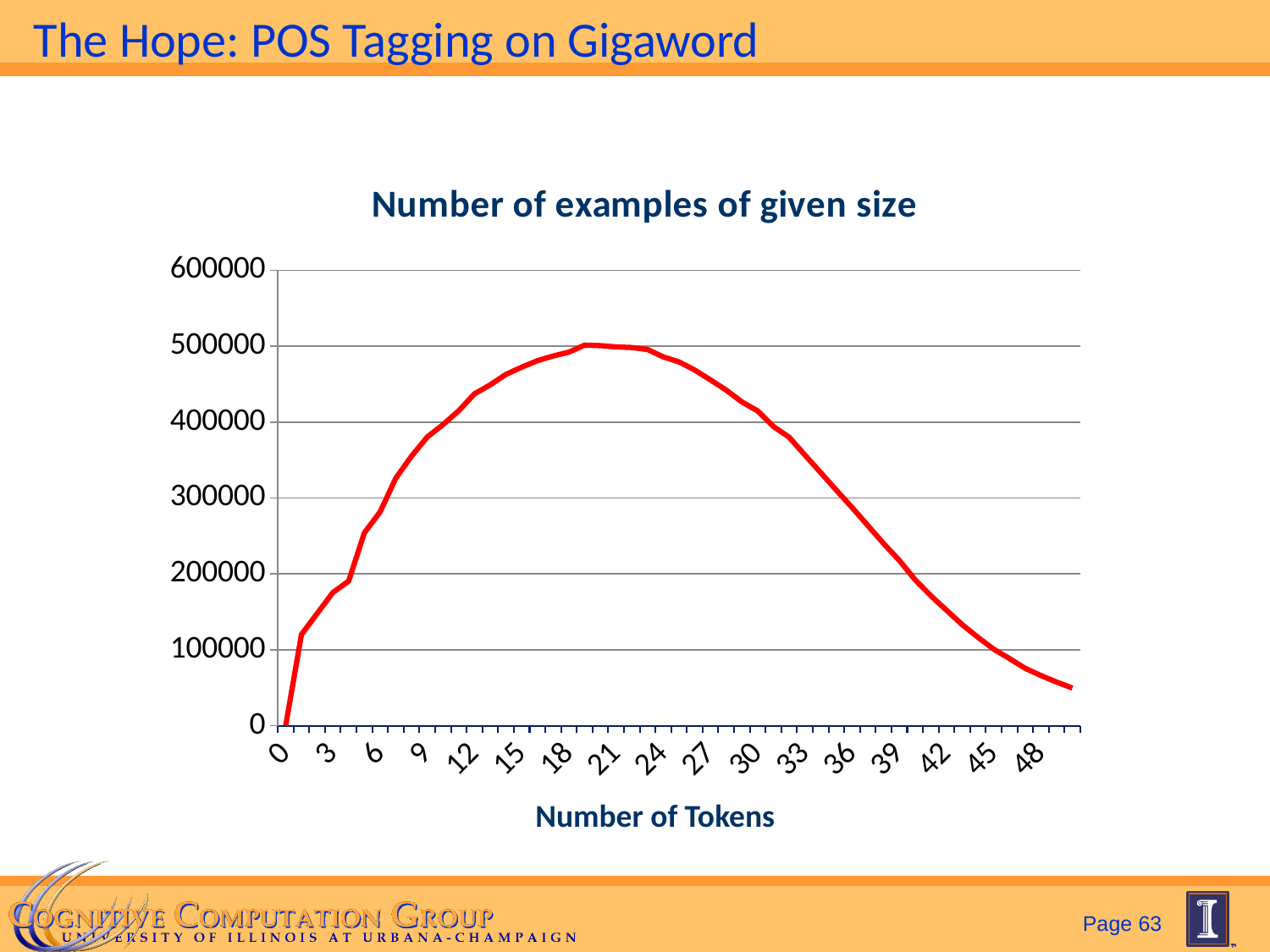
Is the value at 9 tokens greater or less than 300000? greater Which has more examples: 12 tokens or 42 tokens? 12 tokens What kind of chart is shown on the slide? line chart Does the number of examples rise or fall as the number of tokens goes from 0 to 18? rise Is the value at 18 tokens greater or less than 400000? greater Which has more examples: 6 tokens or 30 tokens? 30 tokens Is the value at 48 tokens greater or less than 100000? less Does the number of examples rise or fall as the number of tokens goes from 24 to 48? fall What is the label of the x axis? Number of Tokens What is the title of the chart? Number of examples of given size